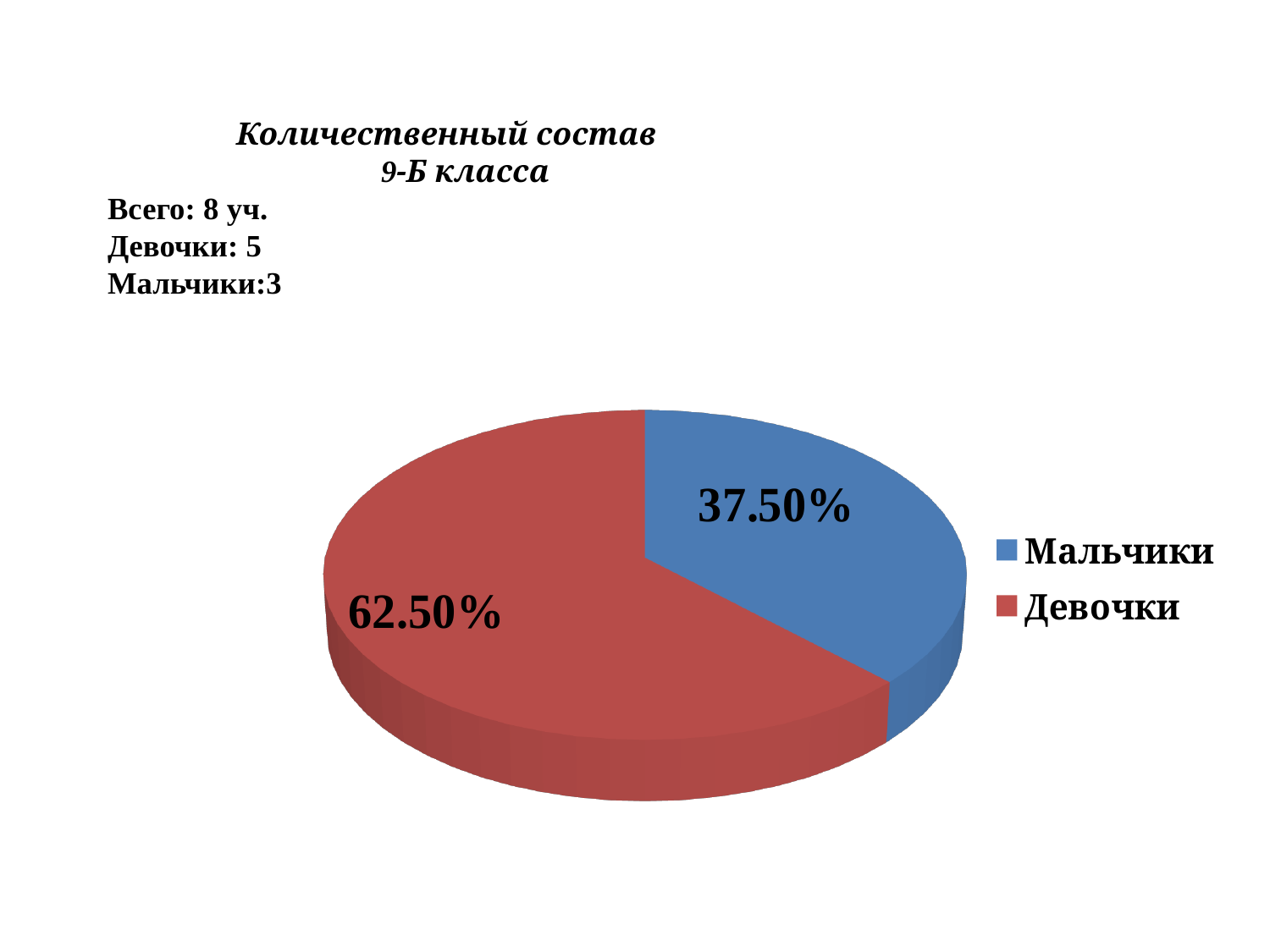
What colour is the Девочки slice in the pie chart? red What kind of chart is shown on the slide? pie chart Which category has the smallest slice of the pie? Мальчики How many entries does the legend list? 2 Which category has the largest slice of the pie? Девочки Which slice is larger, Мальчики or Девочки? Девочки How many slices does the pie chart have? 2 What percentage of the pie is labelled for Мальчики? 37.50% Is the share for Мальчики greater or less than 50%? less What is the title of the chart? Количественный состав 9-Б класса What percentage of the pie is labelled for Девочки? 62.50% What is the difference in percentage points between the Девочки slice and the Мальчики slice? 25 percentage points